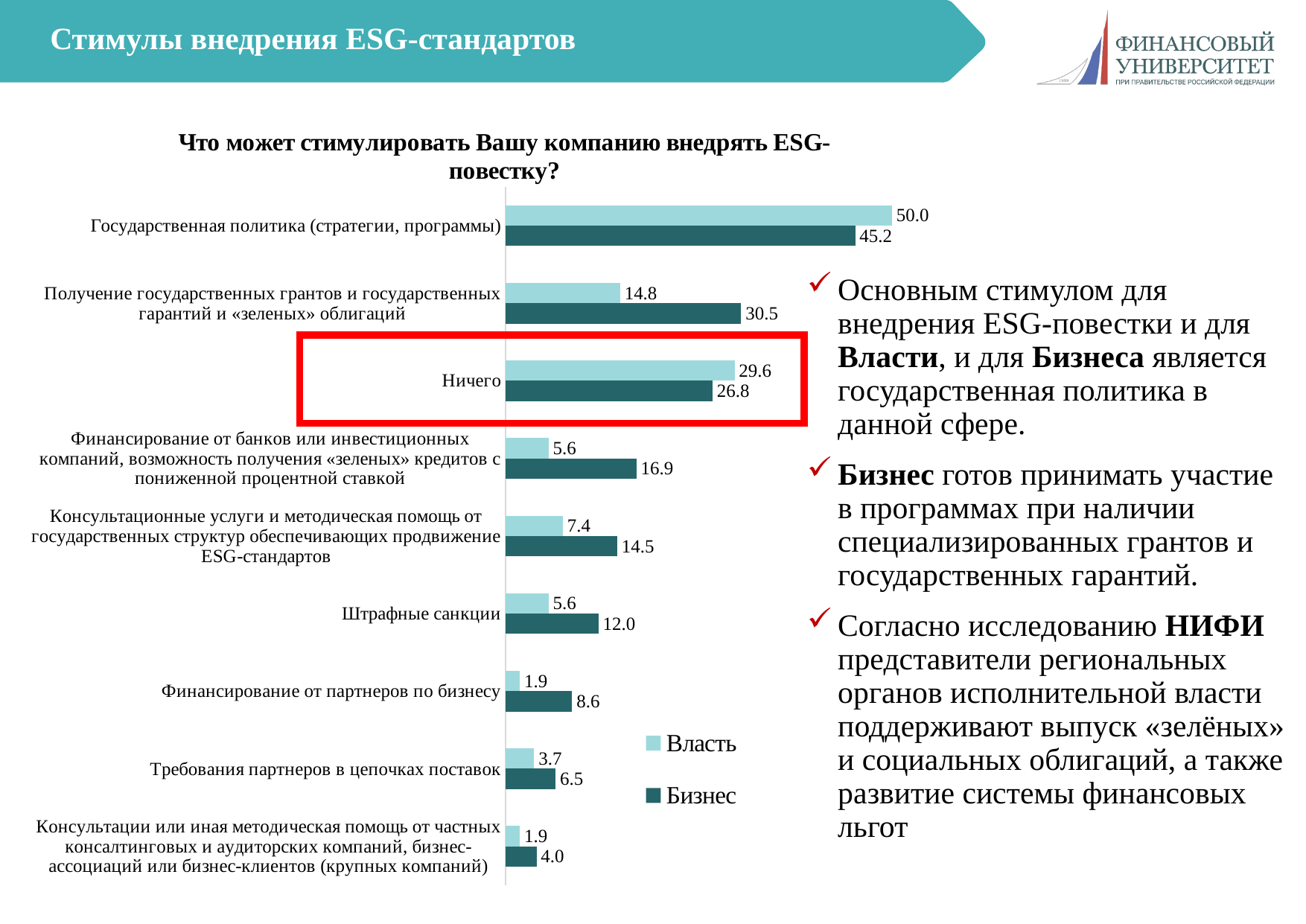
Which category has the lowest value for "Бизнес"? Консультации или иная методическая помощь от частных консалтинговых и аудиторских компаний, бизнес-ассоциаций или бизнес-клиентов (крупных компаний) What is the title of the chart? Что может стимулировать Вашу компанию внедрять ESG-повестку? How many series does the chart legend list? 2 What is the value for "Бизнес" in the category "Штрафные санкции"? 12.0 Which is larger for "Финансирование от партнеров по бизнесу": the value for "Власть" or for "Бизнес"? Бизнес Which category has the highest value for "Власть"? Государственная политика (стратегии, программы) What is the difference between the "Власть" and "Бизнес" values for "Государственная политика (стратегии, программы)"? 4.8 What is the value for "Власть" in the category "Ничего"? 29.6 What is the difference between the "Бизнес" and "Власть" values for "Финансирование от банков или инвестиционных компаний, возможность получения «зеленых» кредитов с пониженной процентной ставкой"? 11.3 How many categories are shown on the chart? 9 What is the value for "Бизнес" in the category "Получение государственных грантов и государственных гарантий и «зеленых» облигаций"? 30.5 What type of chart is shown on the slide? Bar chart